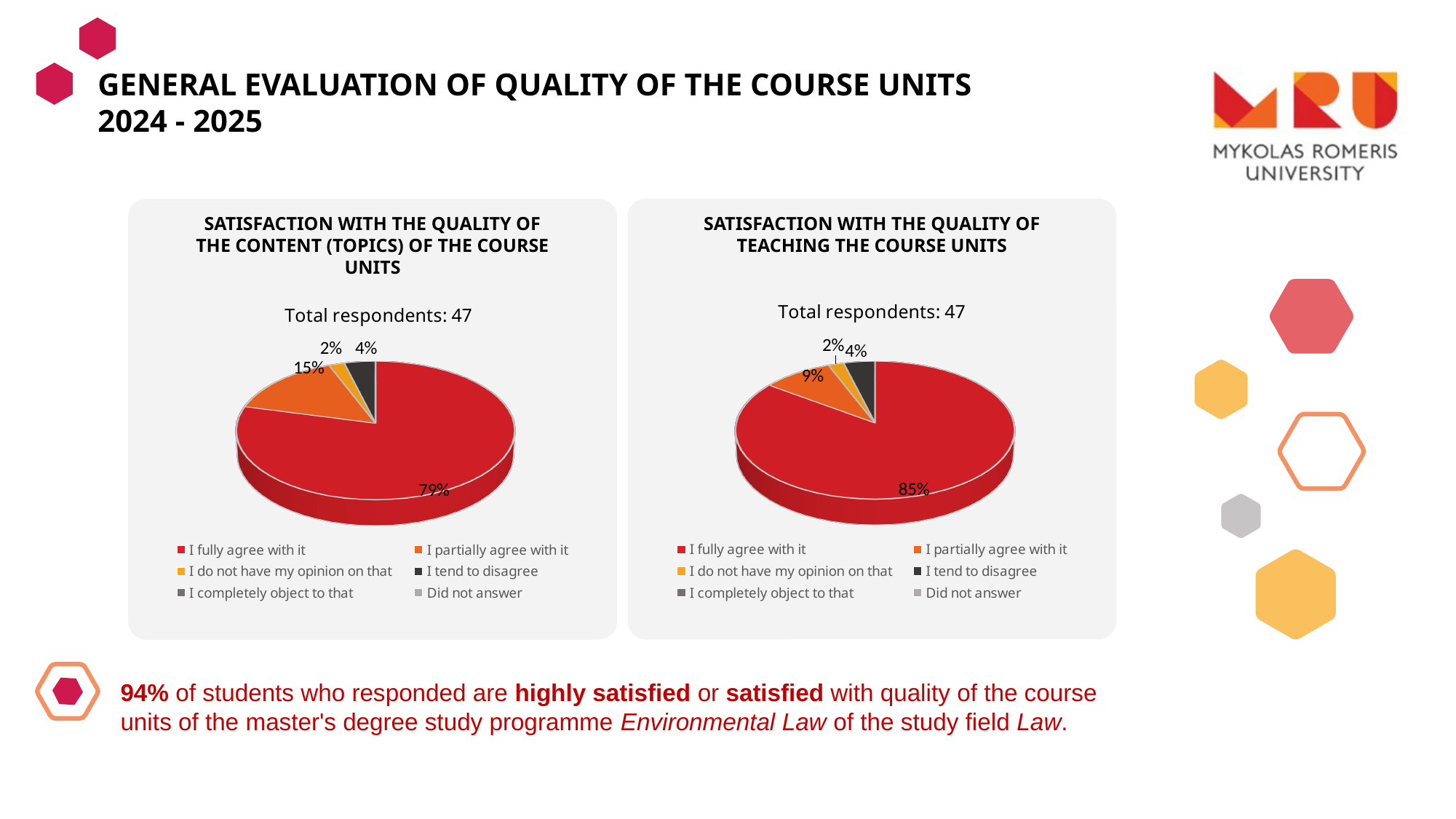
In the chart titled 'Satisfaction with the quality of the content (topics) of the course units', what share of respondents chose 'I fully agree with it'? 79% Which chart has the larger 'I partially agree with it' share, the left chart (content) or the right chart (teaching)? The left chart (content) In the left chart (content of the course units), what share of respondents chose 'I tend to disagree'? 4% In the chart titled 'Satisfaction with the quality of teaching the course units', what share of respondents chose 'I fully agree with it'? 85% What is the difference between the 'I fully agree with it' share in the right chart (teaching) and in the left chart (content)? 6% In the left chart (content of the course units), which response has the largest slice? I fully agree with it In the right chart (teaching the course units), what share of respondents chose 'I do not have my opinion on that'? 2% What type of chart is used on this slide? Pie chart In the right chart (teaching the course units), what share of respondents chose 'I partially agree with it'? 9% How many entries does the legend of the left chart (content of the course units) list? 6 In the left chart (content of the course units), what share of respondents chose 'I partially agree with it'? 15% In the right chart (teaching the course units), which response has the smallest slice? I do not have my opinion on that